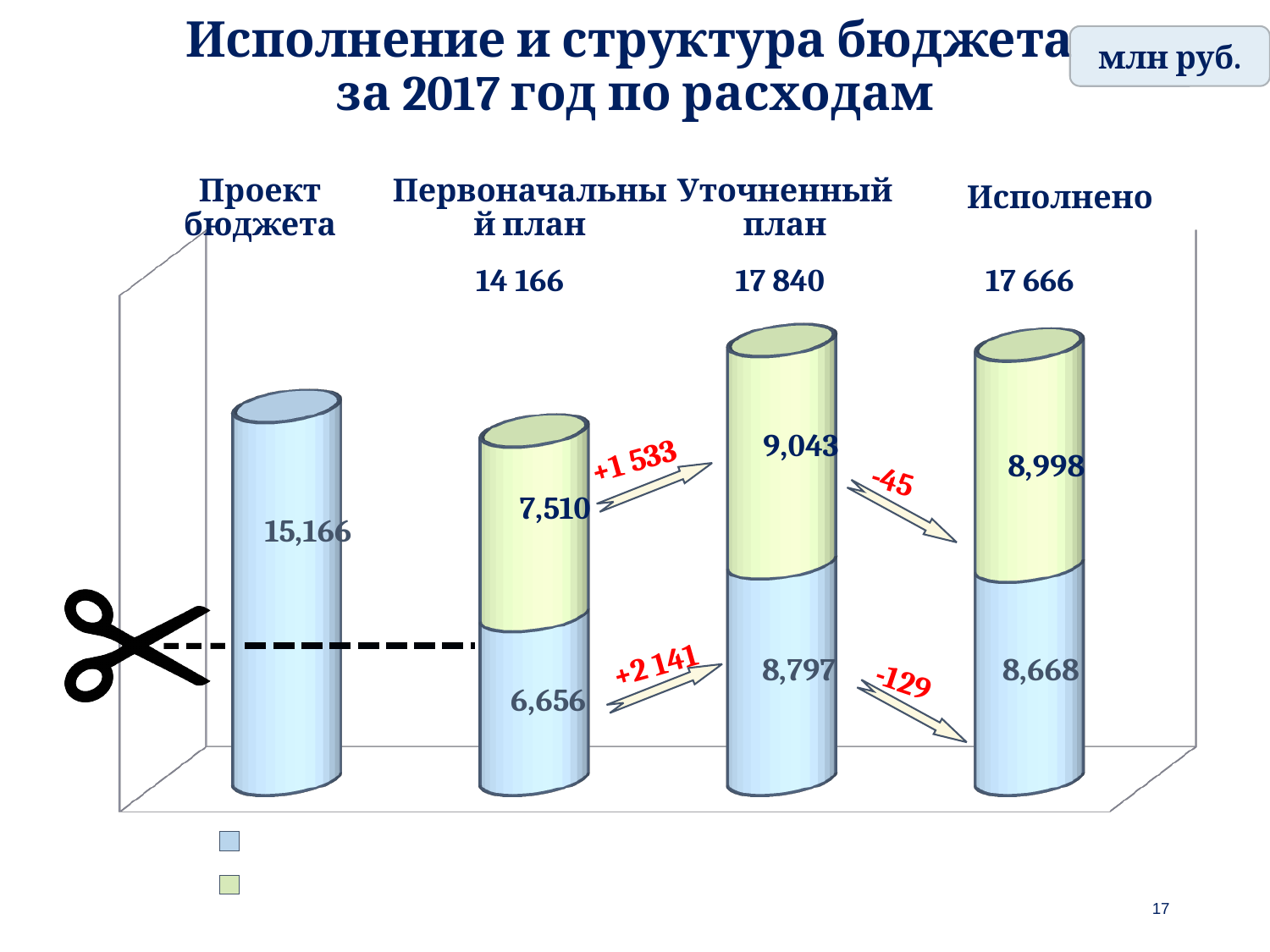
Which category has the highest total value? Уточненный план What is the value of the blue (lower) segment for Исполнено? 8,668 Which is larger: the blue segment of Уточненный план or the blue segment of Первоначальный план? Уточненный план What is the total shown above the Исполнено bar? 17 666 What kind of chart is this? Bar chart What is the value of the green (upper) segment for Уточненный план? 9,043 What is the value of the blue (lower) segment for Первоначальный план? 6,656 What is the value shown for Проект бюджета? 15,166 Which category has the lowest total value? Первоначальный план What is the total shown above the Уточненный план bar? 17 840 What is the difference between the green segment of Уточненный план (9,043) and the green segment of Исполнено (8,998)? 45 How many categories are shown on the x axis? 4